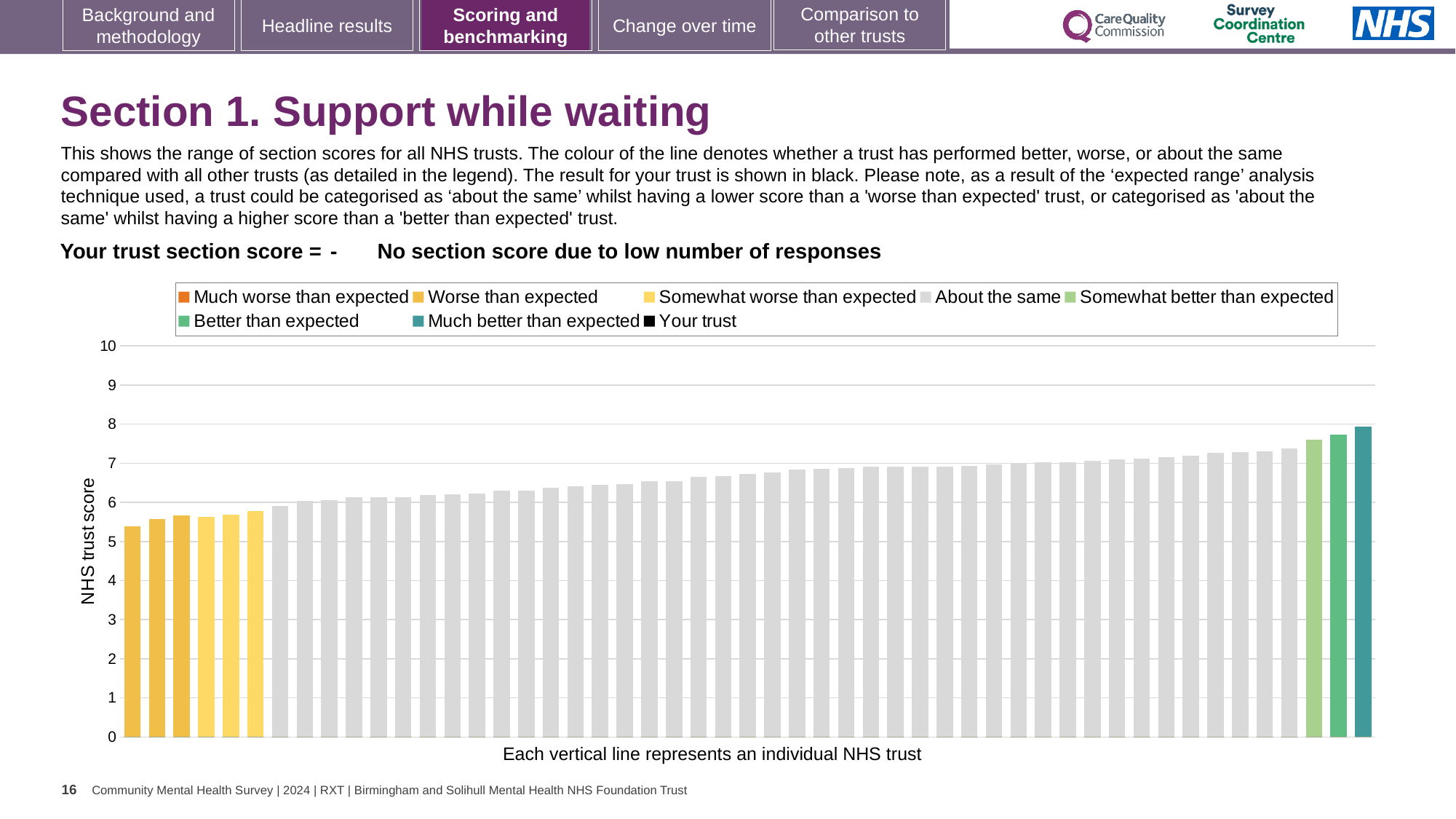
What kind of chart is shown on the slide? bar chart What is the highest value shown on the vertical axis of the chart? 10 How many bars are coloured in the 'Much better than expected' colour? 1 What is given as your trust section score on the slide? - (No section score due to low number of responses) Is the value of the tallest bar in the chart greater or less than 7? greater How many entries does the chart legend list? 8 What is the label on the vertical axis of the chart? NHS trust score Is the value of the shortest bar in the chart greater or less than 5? greater Is the value of the leftmost bar greater or less than 6? less What does the text below the horizontal axis say each vertical line represents? an individual NHS trust How many bars are coloured in the 'Worse than expected' colour? 3 Do the bar heights rise or fall from left to right across the chart? rise